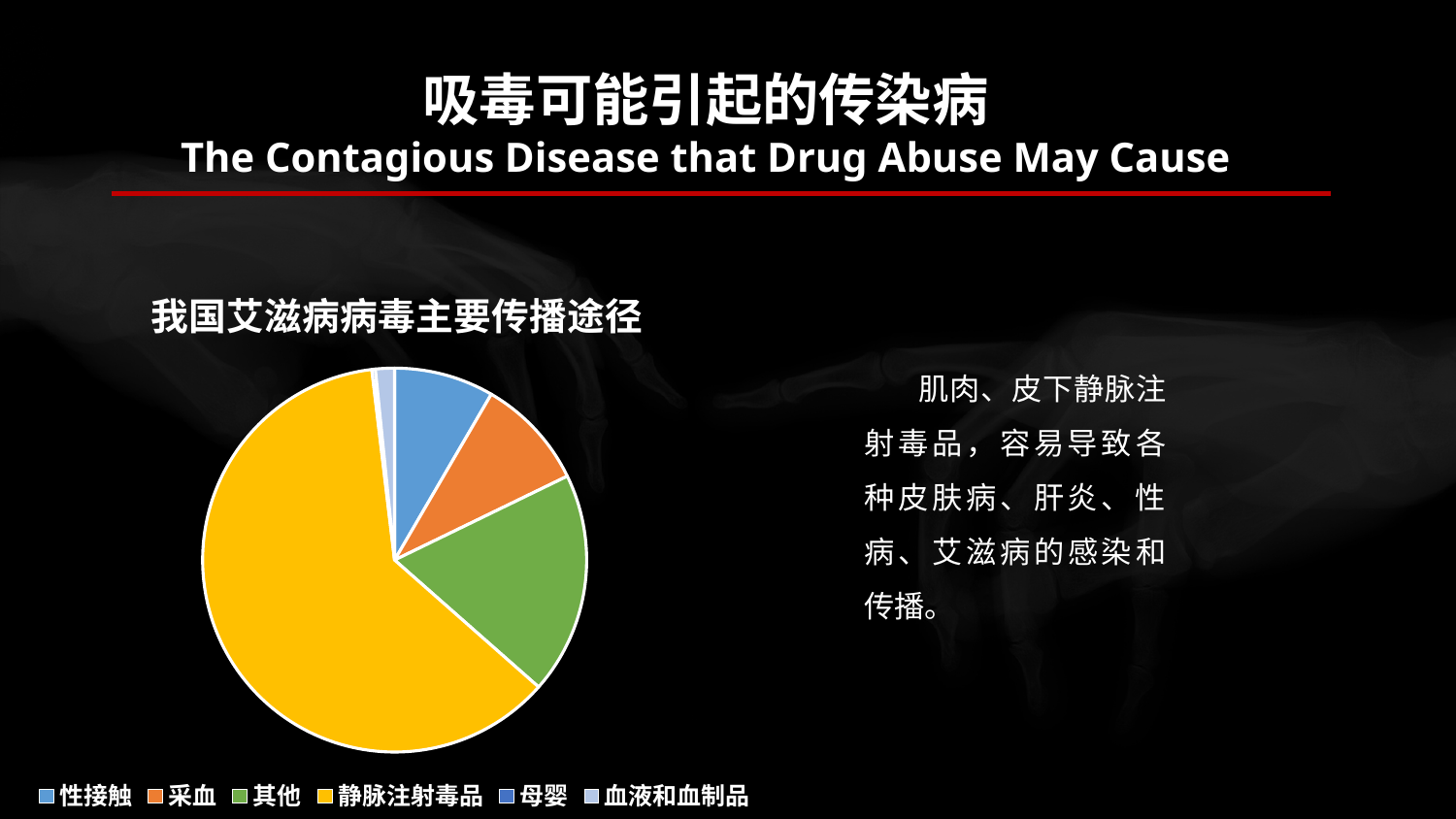
Which slice is larger in the pie chart, 其他 or 性接触? 其他 Does the slice for 静脉注射毒品 take up more or less than half of the pie chart? more How many categories does the legend of the pie chart list? 6 What is the title of the pie chart? 我国艾滋病病毒主要传播途径 What kind of chart is shown on the slide? pie chart Which slice is larger in the pie chart, 性接触 or 血液和血制品? 性接触 What colour is the slice for 静脉注射毒品 in the pie chart? yellow Which category has the largest slice in the pie chart? 静脉注射毒品